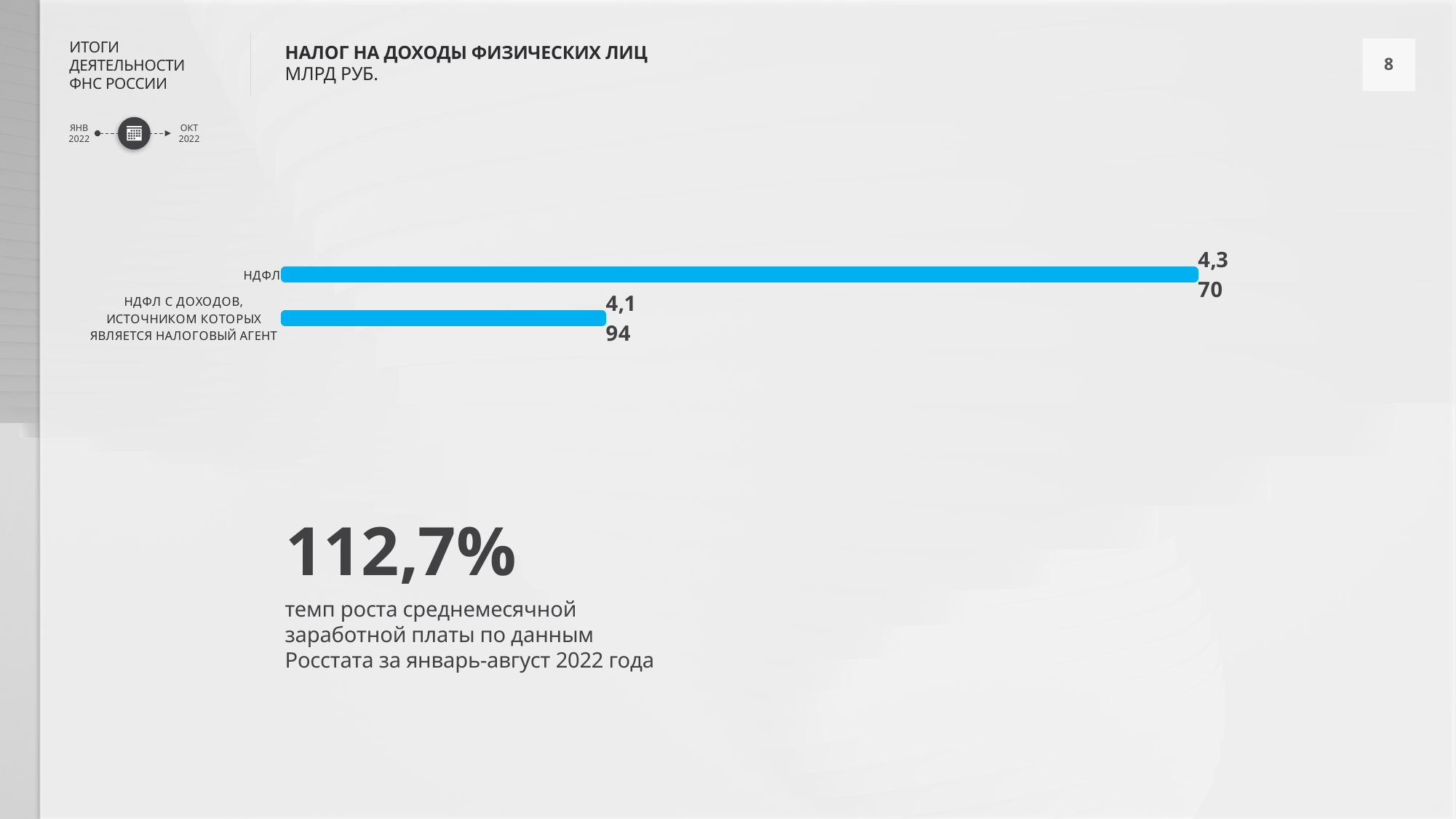
What is the difference between the value for НДФЛ and the value for НДФЛ с доходов, источником которых является налоговый агент? 176 In what units are the chart values given? МЛРД РУБ. Which category has the highest value? НДФЛ What is the title of the chart? НАЛОГ НА ДОХОДЫ ФИЗИЧЕСКИХ ЛИЦ What is the value shown for НДФЛ с доходов, источником которых является налоговый агент? 4,194 What is the value shown for НДФЛ? 4,370 What kind of chart is shown on the slide? Bar chart How many categories are plotted in the chart? 2 Which is larger: the value for НДФЛ or the value for НДФЛ с доходов, источником которых является налоговый агент? НДФЛ Which category has the lowest value? НДФЛ с доходов, источником которых является налоговый агент